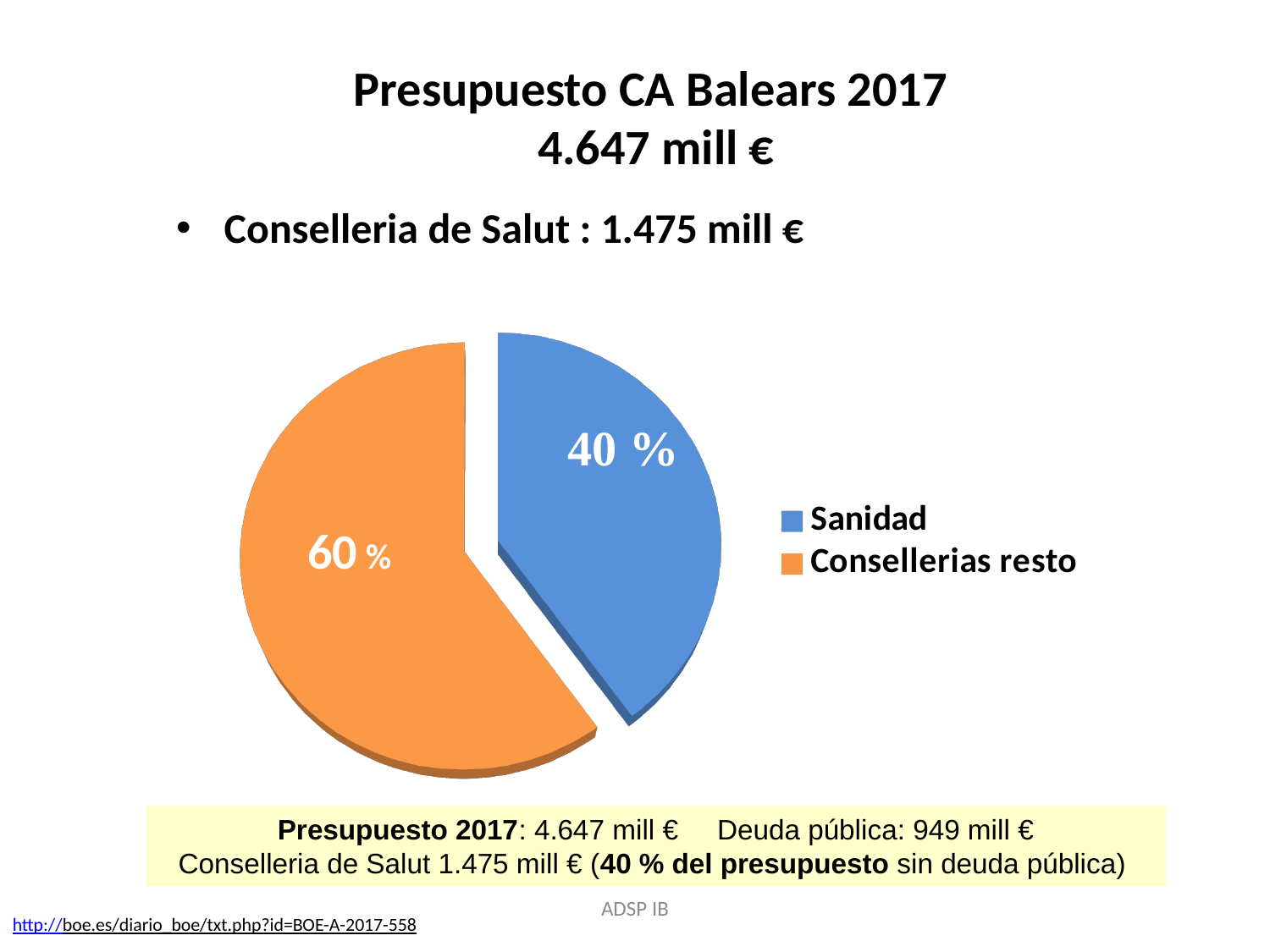
What colour is the Consellerias resto slice? orange What kind of chart is shown on the slide? pie chart How many entries does the legend list? 2 What share of the pie does Consellerias resto represent? 60 % Which slice of the pie is the smallest? Sanidad What share of the pie does Sanidad represent? 40 % What colour is the Sanidad slice? blue Which is larger, the Sanidad slice or the Consellerias resto slice? Consellerias resto What is the difference in percentage points between the Consellerias resto slice and the Sanidad slice? 20 % Is the share for Sanidad greater or less than 50%? less Which slice of the pie is the largest? Consellerias resto How many slices does the pie chart have? 2